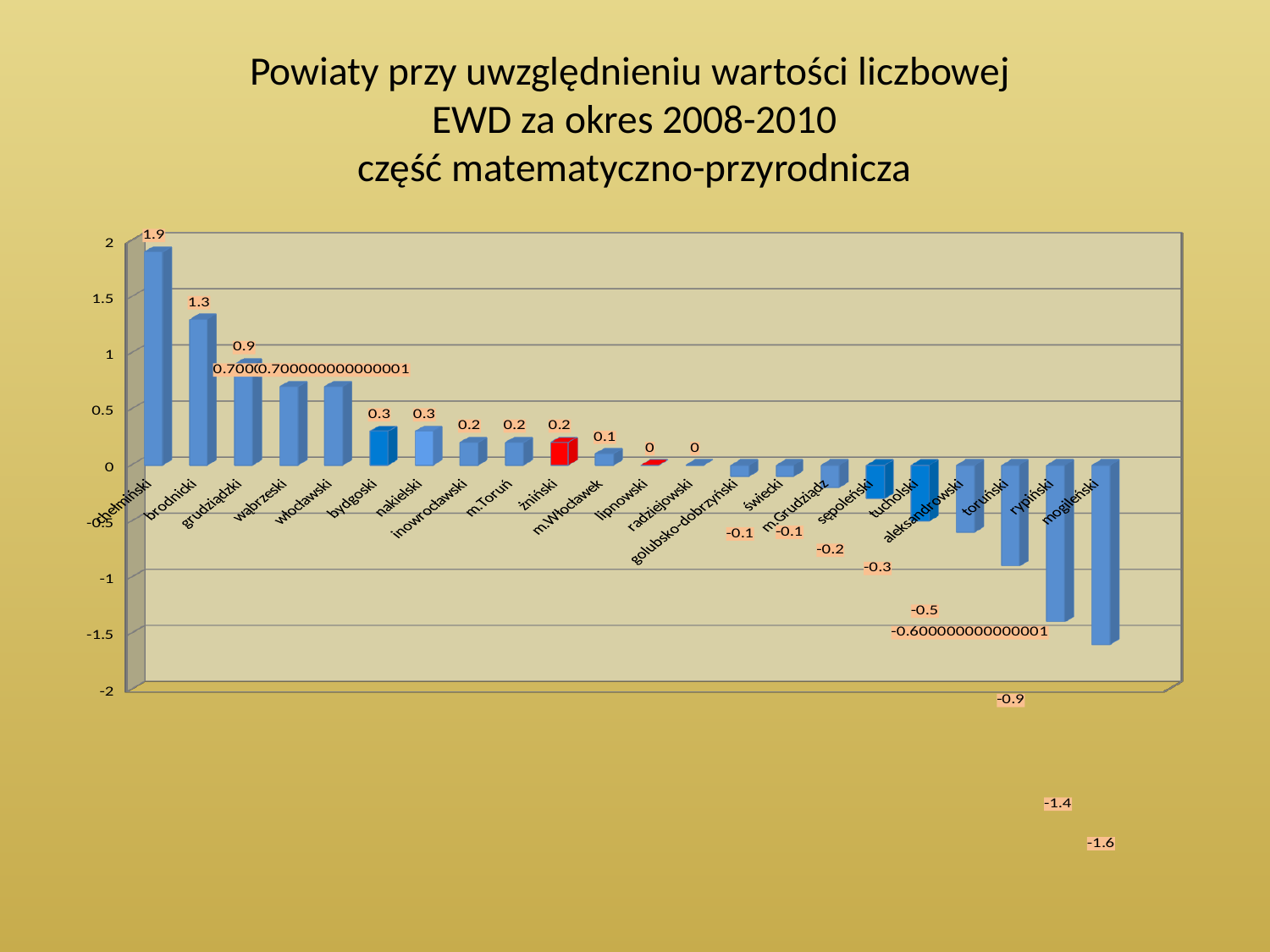
Is the value for rypiński greater or less than -1? less What is the value for chełmiński? 1.9 Which category has the lowest value? mogileński What is the difference between the values for chełmiński and brodnicki? 0.6 Which is larger, the value for brodnicki or the value for grudziądzki? brodnicki What is the value for brodnicki? 1.3 What kind of chart is this? bar chart What is the value for grudziądzki? 0.9 Which category has the highest value? chełmiński How many categories are shown on the x axis? 22 Do the values rise or fall from left to right along the x axis? fall What is the value for m.Włocławek? 0.1